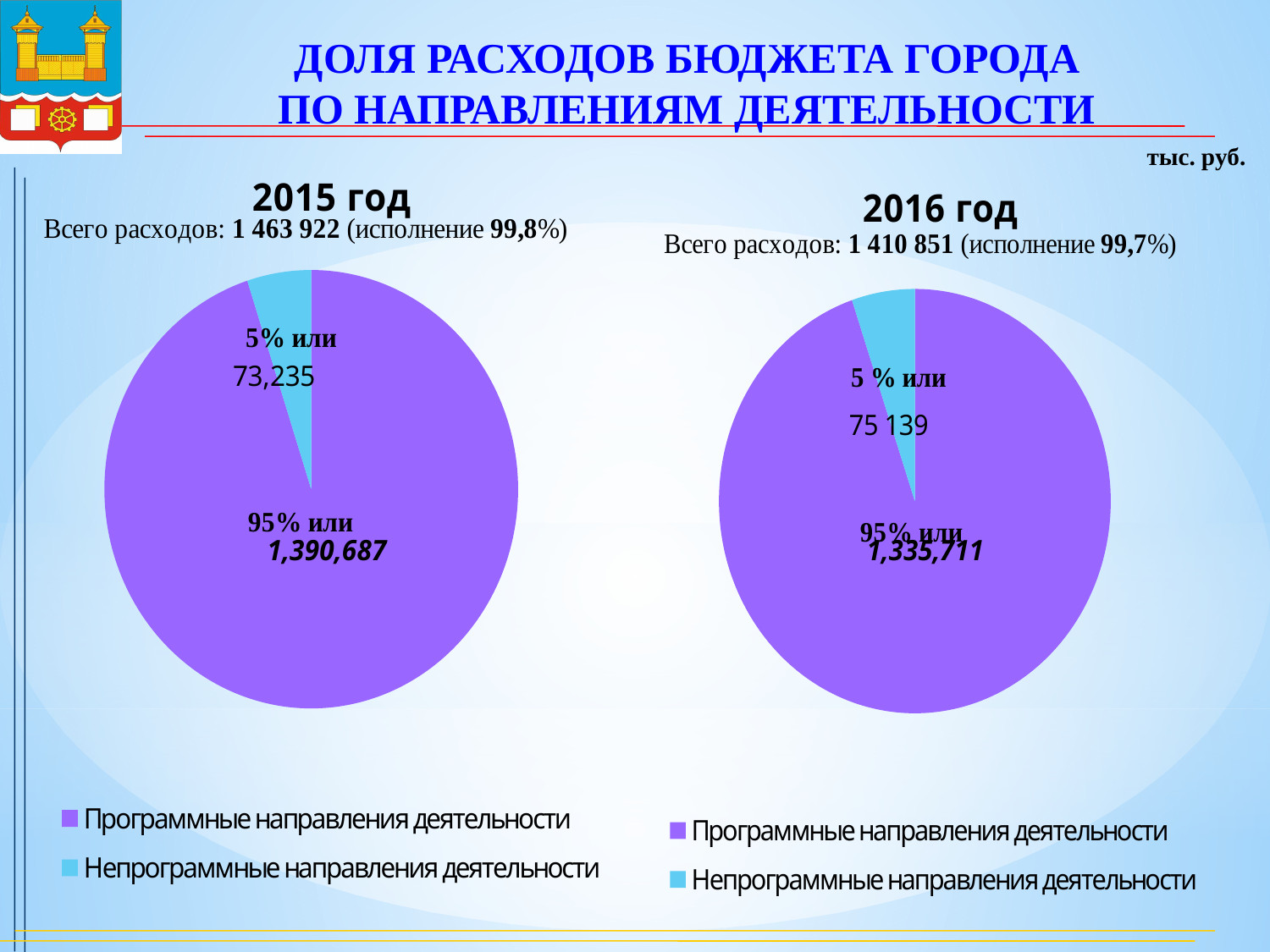
How many slices does the 2016 год pie chart have? 2 In the 2015 год chart, what value is shown for Непрограммные направления деятельности? 73,235 In the 2016 год chart, which category is the largest? Программные направления деятельности How many entries does the legend of the 2015 год chart list? 2 In the 2016 год chart, what value is shown for Непрограммные направления деятельности? 75 139 In the 2015 год chart, what value is shown for Программные направления деятельности? 1,390,687 In the 2015 год chart, which category is the smallest? Непрограммные направления деятельности In the 2016 год chart, what share of the pie is Программные направления деятельности? 95% In the 2015 год chart, what colour is the slice for Непрограммные направления деятельности? light blue What type of chart is used for the 2015 год chart? pie chart In the 2016 год chart, what value is shown for Программные направления деятельности? 1,335,711 In the 2015 год chart, what share of the pie is Непрограммные направления деятельности? 5%